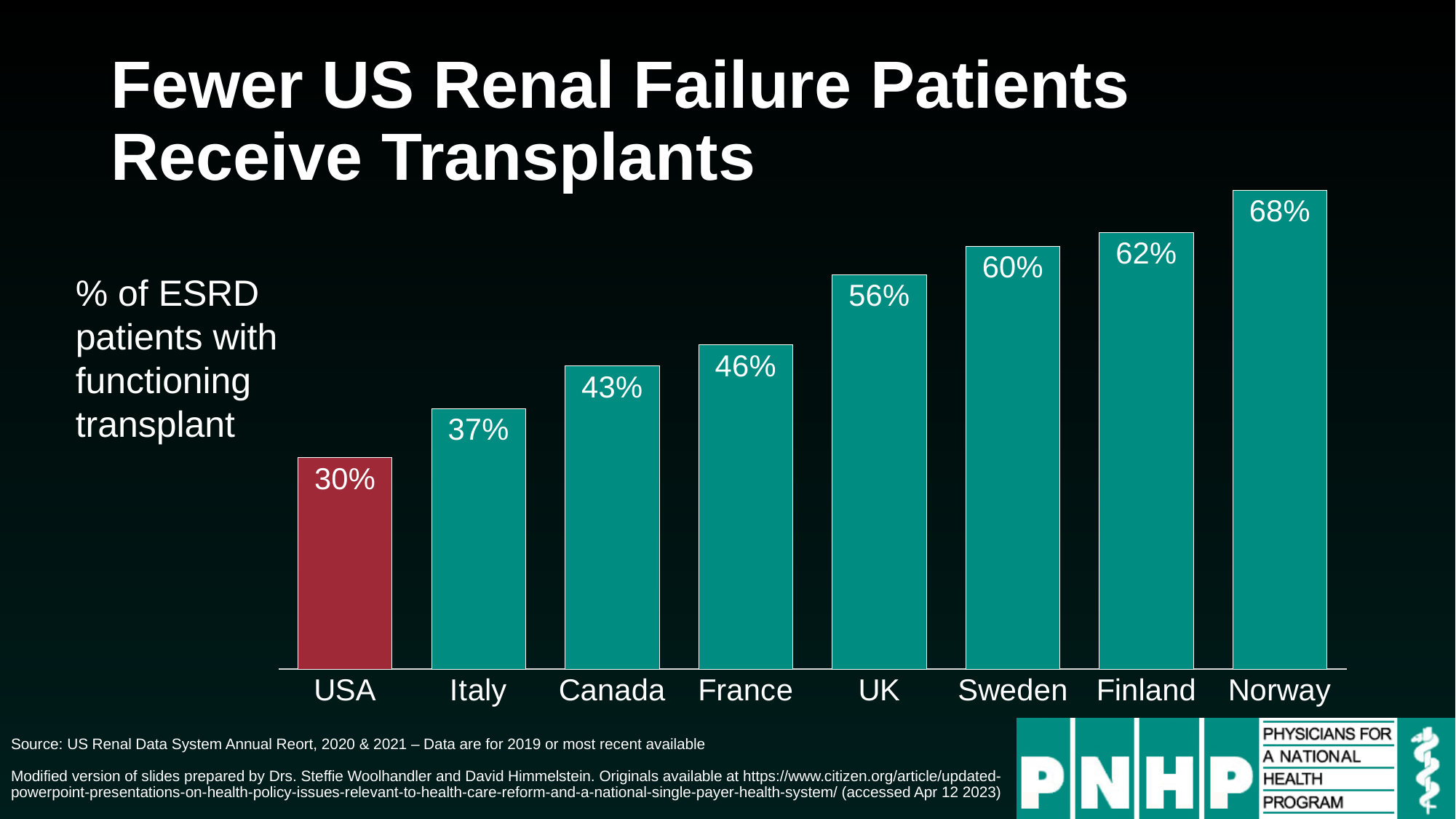
Which bar is coloured differently (red) from the others? USA What is the value shown for Sweden? 60% What is the value shown for Canada? 43% How many countries are shown in the chart? 8 Which country has the lowest percentage of ESRD patients with a functioning transplant? USA What percentage of ESRD patients in the USA have a functioning transplant? 30% Do the values rise or fall from left to right across the countries? Rise Which country has the highest percentage of ESRD patients with a functioning transplant? Norway What kind of chart is shown on the slide? Bar chart Which has a higher value, Italy or Finland? Finland What is the difference between Norway's value and the USA's value? 38% What is the difference between the UK's value and France's value? 10%